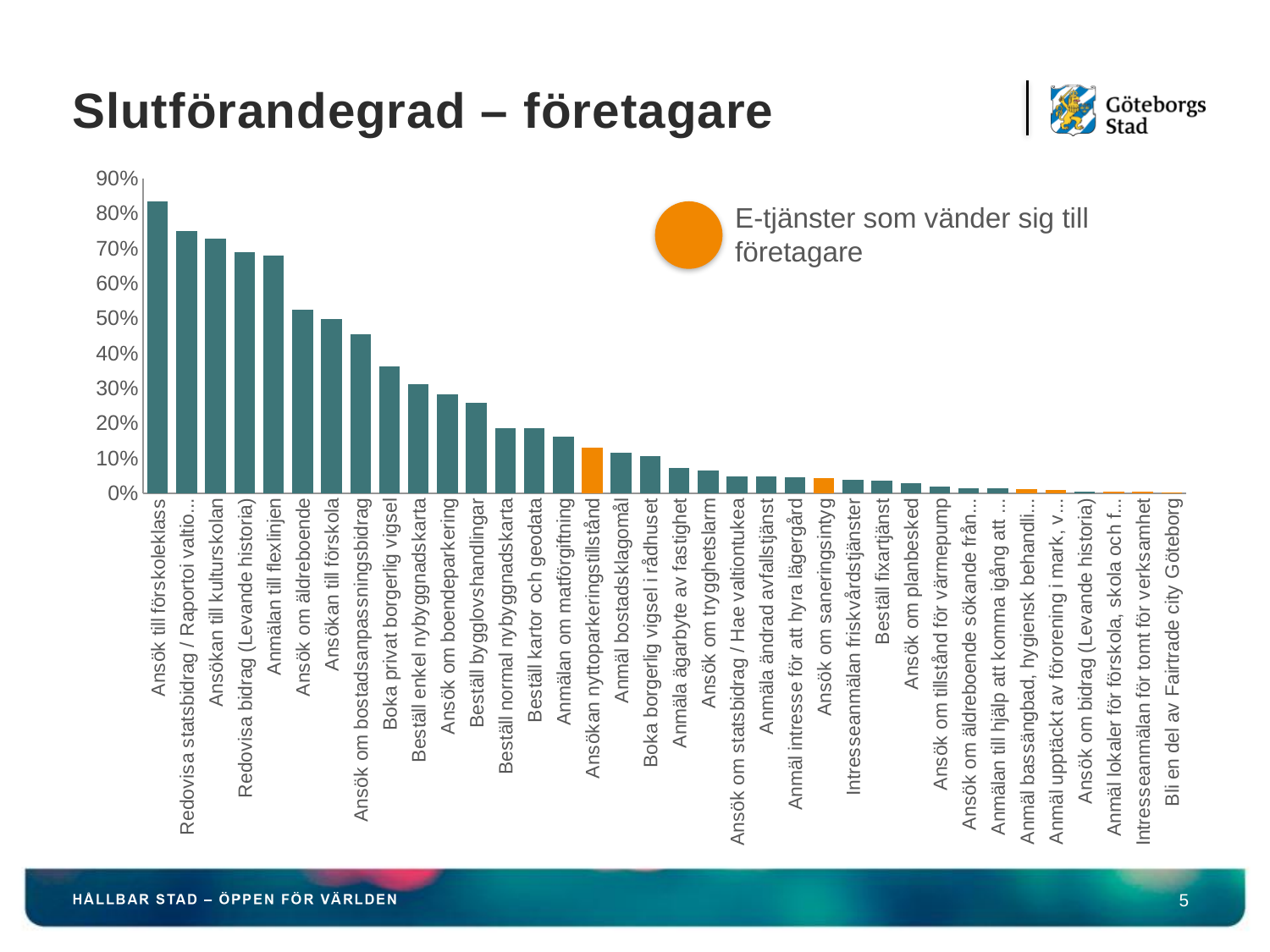
Is the value for Boka privat borgerlig vigsel greater or less than 30%? greater Which has a higher value, Boka privat borgerlig vigsel or Boka borgerlig vigsel i rådhuset? Boka privat borgerlig vigsel Which has a higher value, Ansök till förskoleklass or Ansökan till förskola? Ansök till förskoleklass Is the value for Ansök till förskoleklass greater or less than 80%? greater Which category has the highest value? Ansök till förskoleklass Is the value for Ansök om trygghetslarm greater or less than 10%? less According to the legend, what do the orange bars represent? E-tjänster som vänder sig till företagare What kind of chart is shown on the slide? Bar chart Do the values rise or fall from left to right along the x axis? Fall